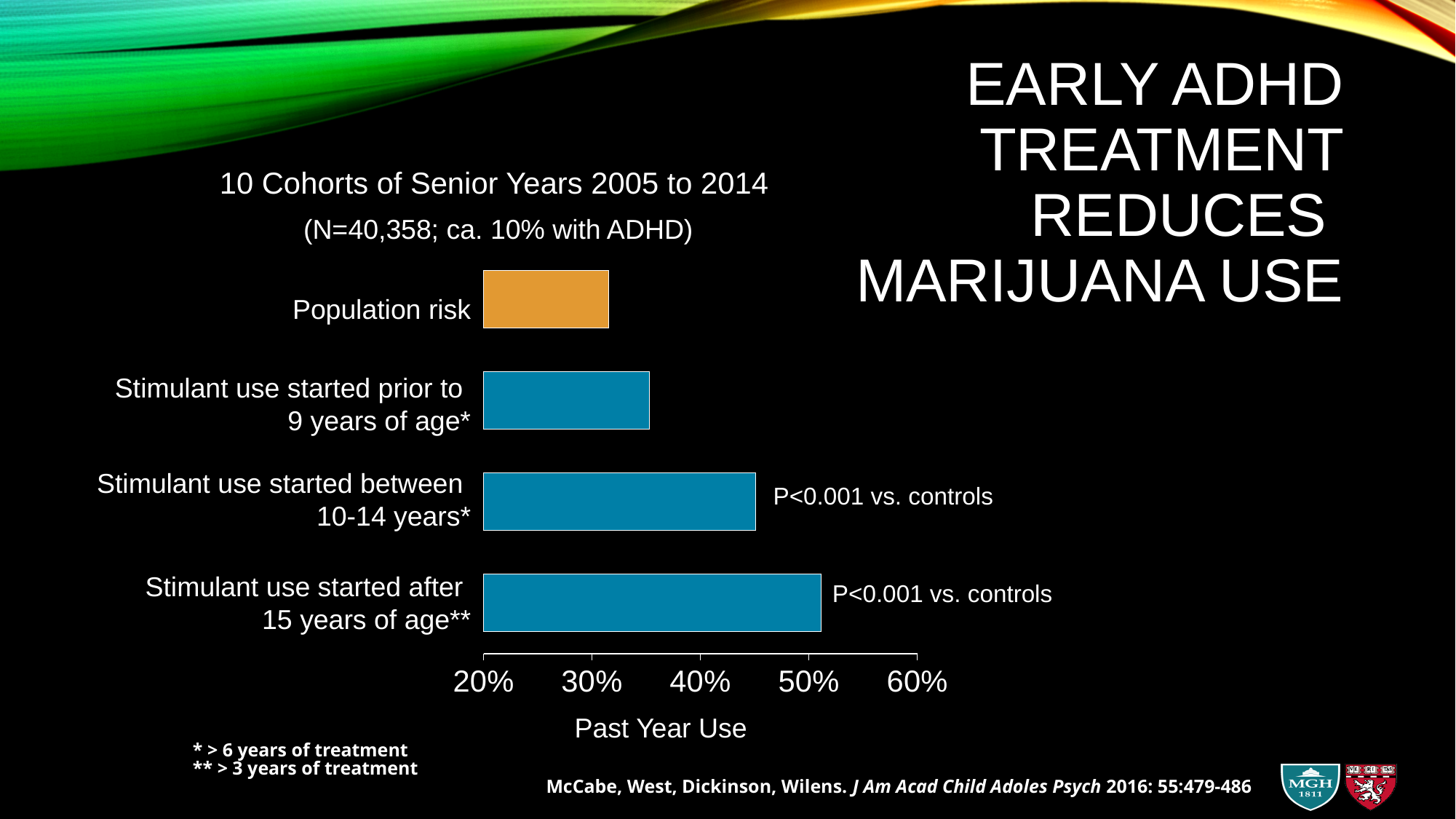
Is the value for Stimulant use started prior to 9 years of age greater or less than 40%? less What kind of chart is shown on the slide? bar chart Is the value for Stimulant use started after 15 years of age greater or less than 40%? greater Which category has the lowest past year use? Population risk Is the value for Stimulant use started between 10-14 years greater or less than 40%? greater What is the title of the chart? 10 Cohorts of Senior Years 2005 to 2014 Which is larger: the value for Population risk or the value for Stimulant use started after 15 years of age? Stimulant use started after 15 years of age What is the label of the horizontal axis of the chart? Past Year Use Which category has the highest past year use? Stimulant use started after 15 years of age** Which is larger: the value for Stimulant use started between 10-14 years or the value for Stimulant use started prior to 9 years of age? Stimulant use started between 10-14 years How many categories are plotted in the chart? 4